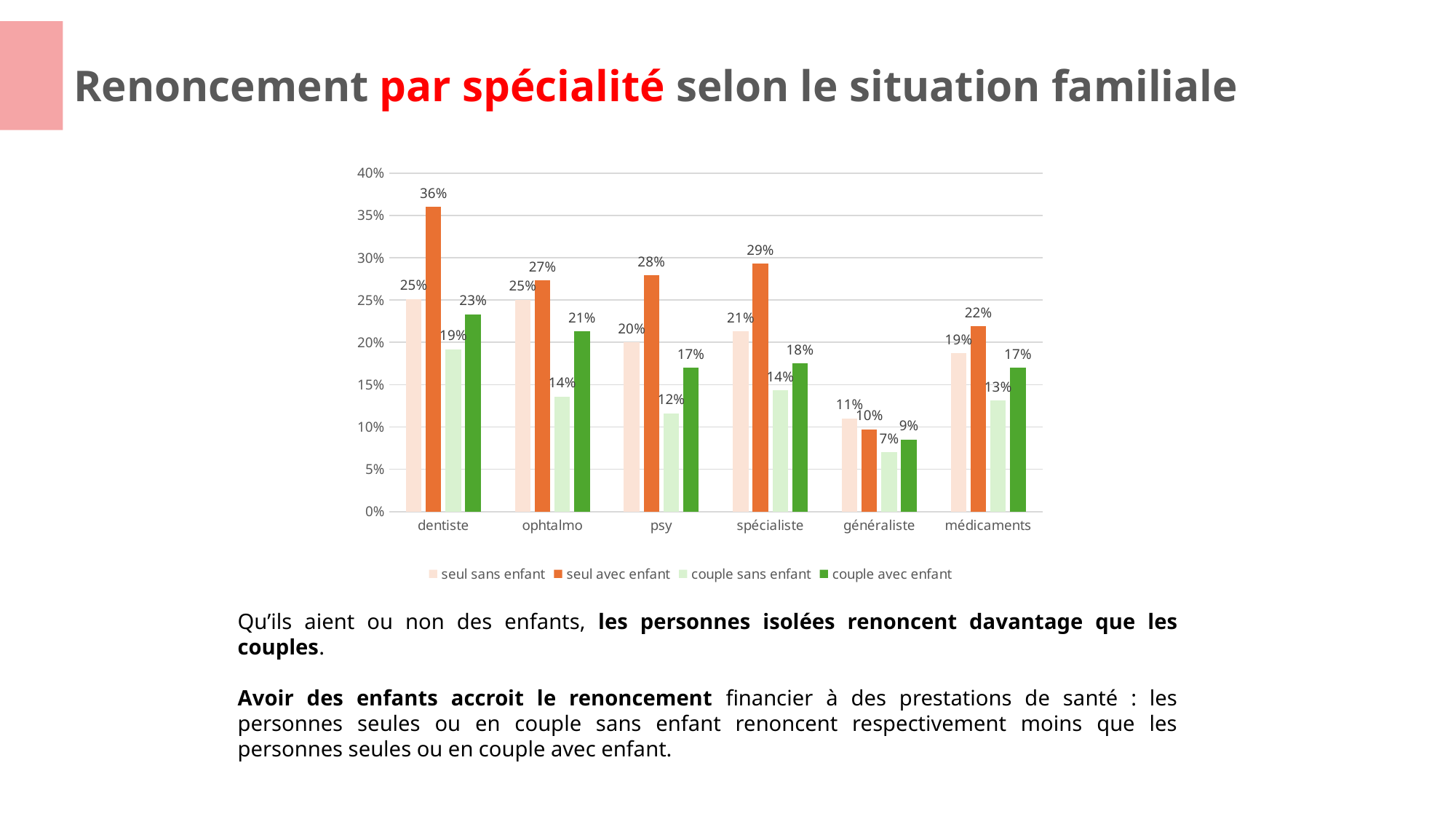
What is the value for 'seul avec enfant' in the dentiste category? 36% Is the value for 'seul avec enfant' in the spécialiste category greater or less than 25%? greater What is the difference between 'seul avec enfant' and 'couple sans enfant' in the psy category? 16% Which category has the highest value for the 'seul avec enfant' series? dentiste Which series is shown in dark green in the legend? couple avec enfant Which category has the lowest value for the 'couple avec enfant' series? généraliste How many series does the legend list? 4 What is the value for 'couple avec enfant' in the ophtalmo category? 21% What is the value for 'couple sans enfant' in the généraliste category? 7% Which is larger in the médicaments category: 'seul sans enfant' or 'couple avec enfant'? seul sans enfant How many categories are shown on the x axis? 6 What kind of chart is shown on the slide? bar chart